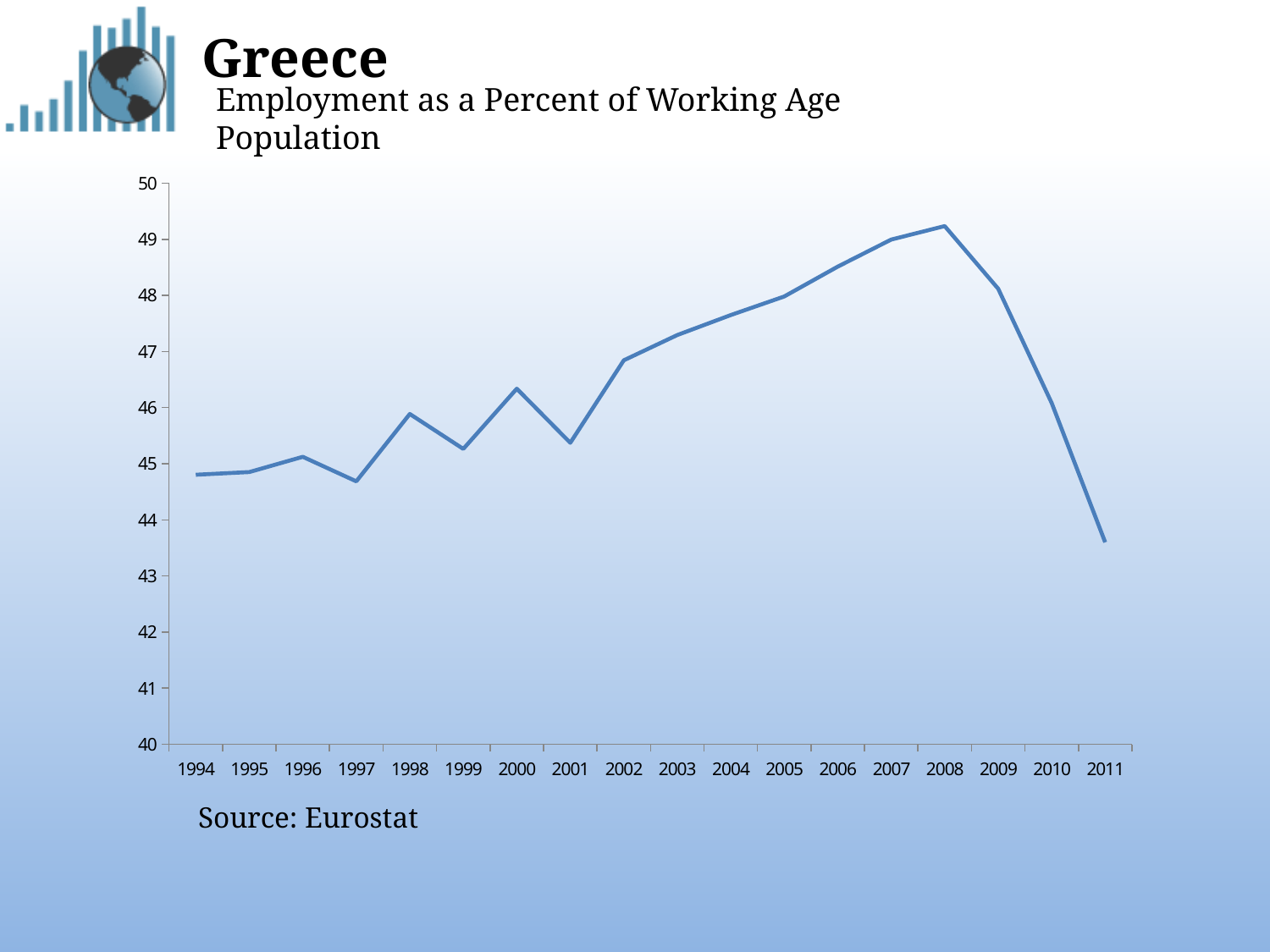
How many years are plotted along the x axis? 18 In which year is the employment rate lowest? 2011 Which year has the higher value, 2009 or 2010? 2009 In which year is the employment rate highest? 2008 Which year has the higher value, 2000 or 2001? 2000 Is the value for 2005 greater or less than 47? greater Is the value for 2011 greater or less than 44? less Is the value for 1994 greater or less than 45? less Do the values rise or fall from 2008 to 2011? fall What kind of chart is shown on the slide? line chart What is the source cited for the chart data? Eurostat